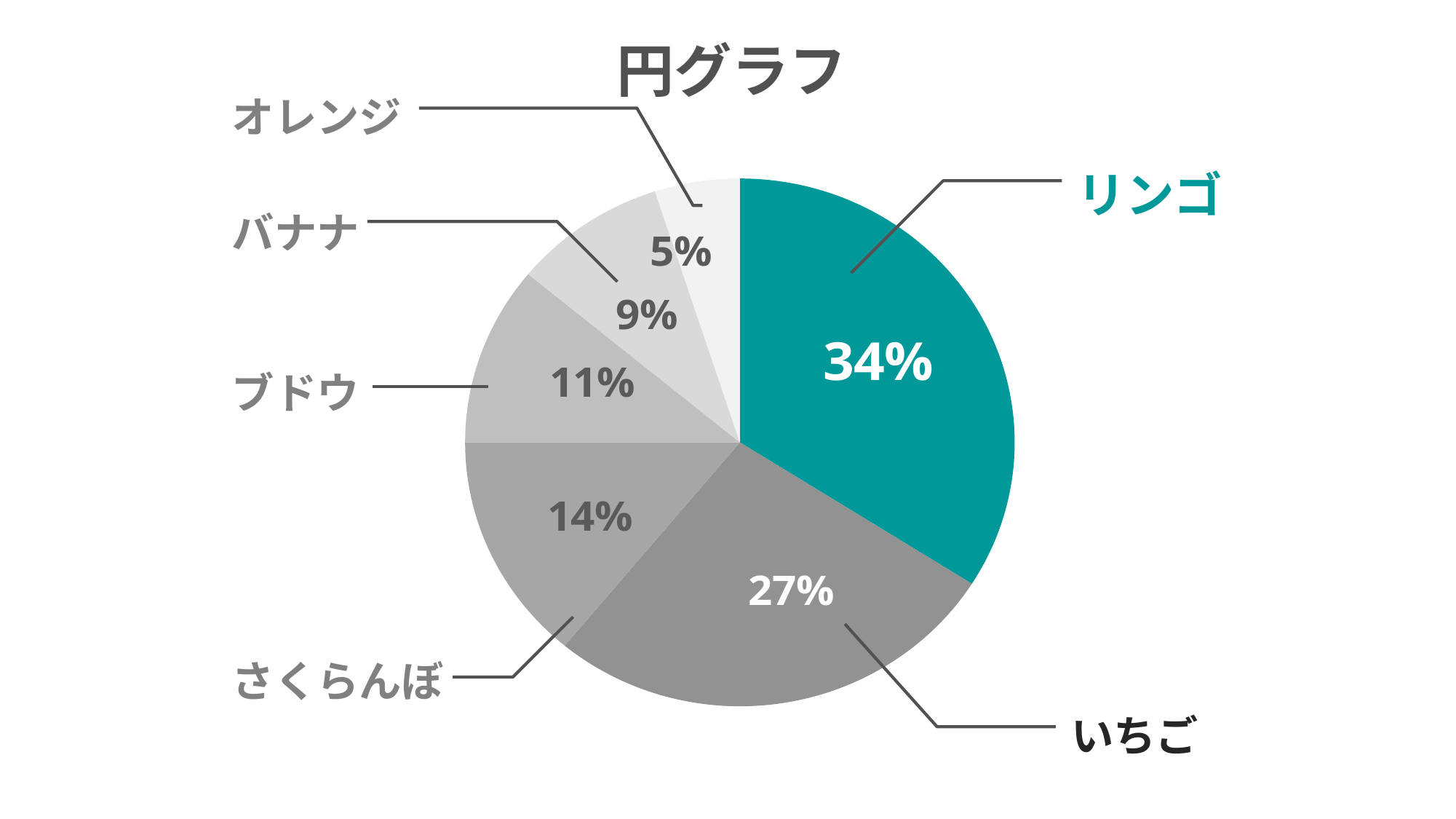
Which is larger, the value for さくらんぼ or the value for ブドウ? さくらんぼ Which category has the largest slice of the pie? リンゴ How many categories are shown in the pie chart? 6 What share of the pie does リンゴ have? 34% What is the value shown for さくらんぼ? 14% What is the title of the chart? 円グラフ What is the value shown for ブドウ? 11% Which category has the smallest slice of the pie? オレンジ What is the value shown for バナナ? 9% What is the difference between the values for リンゴ and いちご? 7% What is the value shown for オレンジ? 5% What is the value shown for いちご? 27%